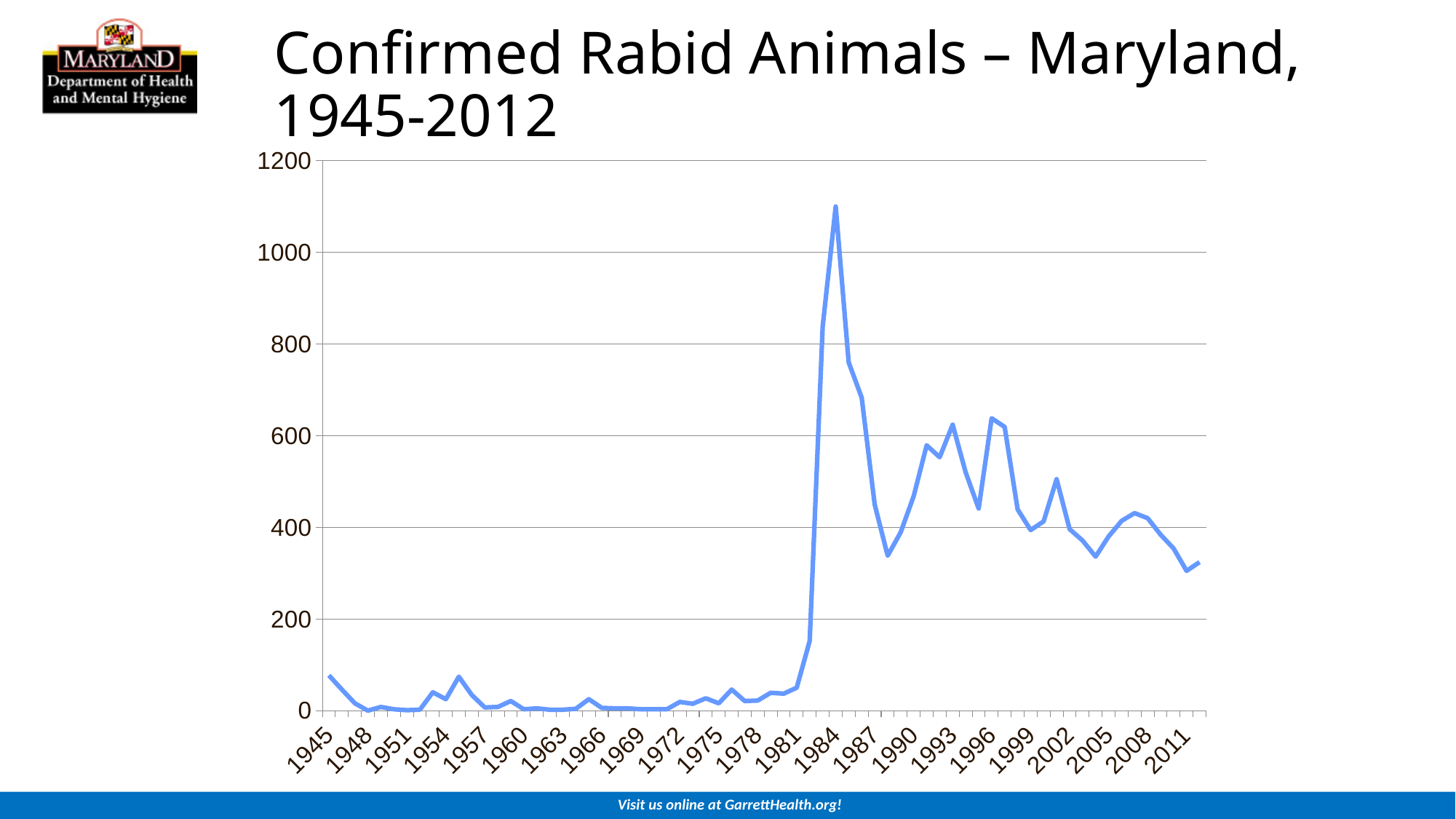
What kind of chart is shown on the slide? line chart Is the value for 1945 greater or less than 200? less In which year does the number of confirmed rabid animals reach its highest point? 1984 Is the value for 1993 greater or less than 400? greater Which year has the larger value, 1984 or 1990? 1984 Is the value for 1984 greater or less than 1000? greater What is the title of the chart? Confirmed Rabid Animals – Maryland, 1945-2012 What colour is the line plotted on the chart? blue Do the values rise or fall between 1981 and 1984? rise Do the values rise or fall between 1984 and 1987? fall